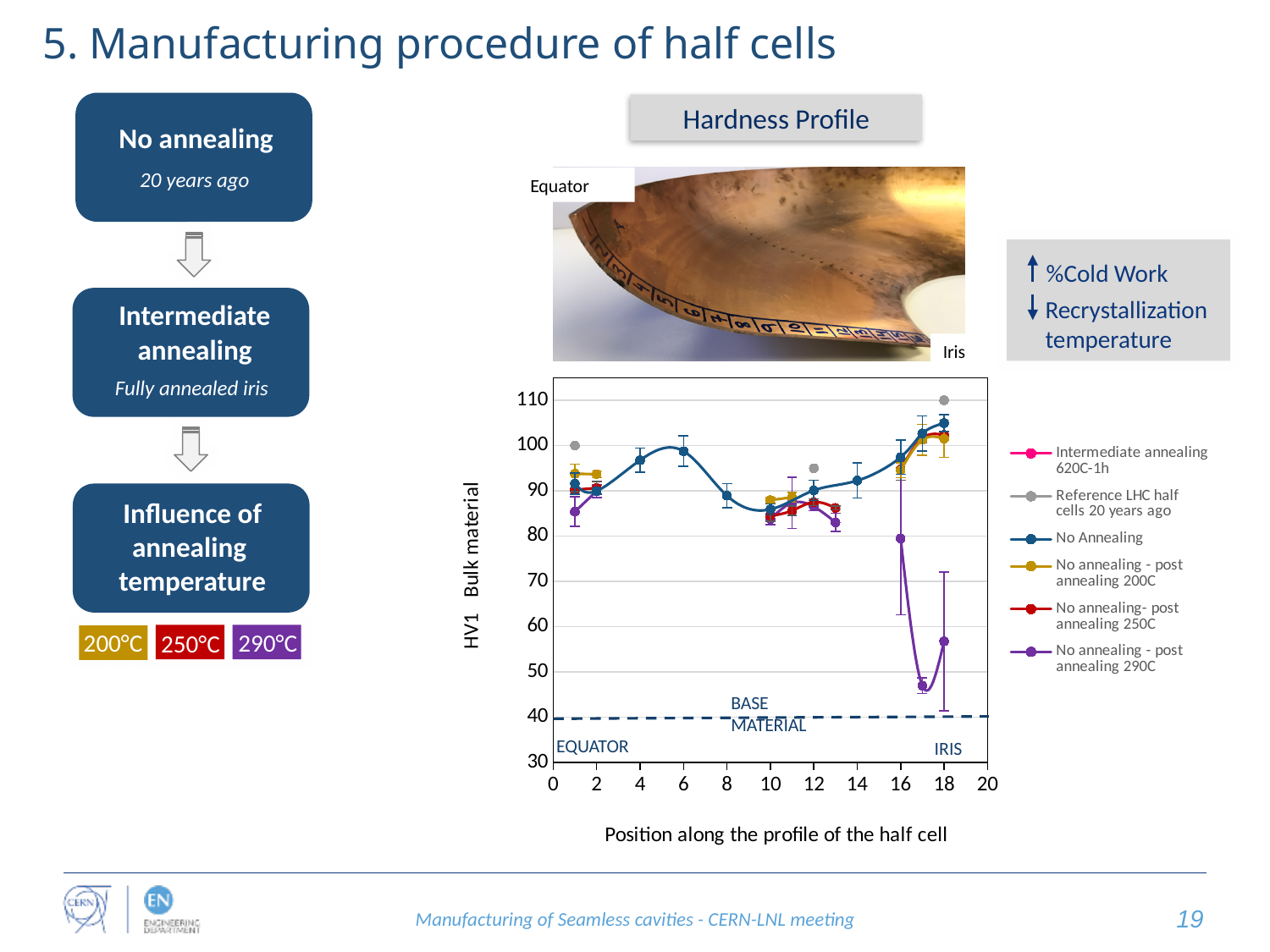
What is the x-axis label of the Hardness Profile chart? Position along the profile of the half cell At what hardness value does the dashed BASE MATERIAL line sit on the Hardness Profile chart? 40 Which series has the highest point on the Hardness Profile chart? Reference LHC half cells 20 years ago How many series does the legend of the Hardness Profile chart list? 6 Which series reaches the lowest value on the Hardness Profile chart? No annealing - post annealing 290C Is the value for Reference LHC half cells 20 years ago at position 18 greater or less than 100? greater At position 18, which is larger: No Annealing or No annealing - post annealing 290C? No Annealing What is the y-axis label of the Hardness Profile chart? HV1 Bulk material Does the No Annealing series rise or fall between position 10 and position 18? rise Is the value for No Annealing at position 10 greater or less than 90? less What kind of chart is shown under the Hardness Profile heading? Line chart Is the value for No annealing - post annealing 290C at position 17 greater or less than 60? less